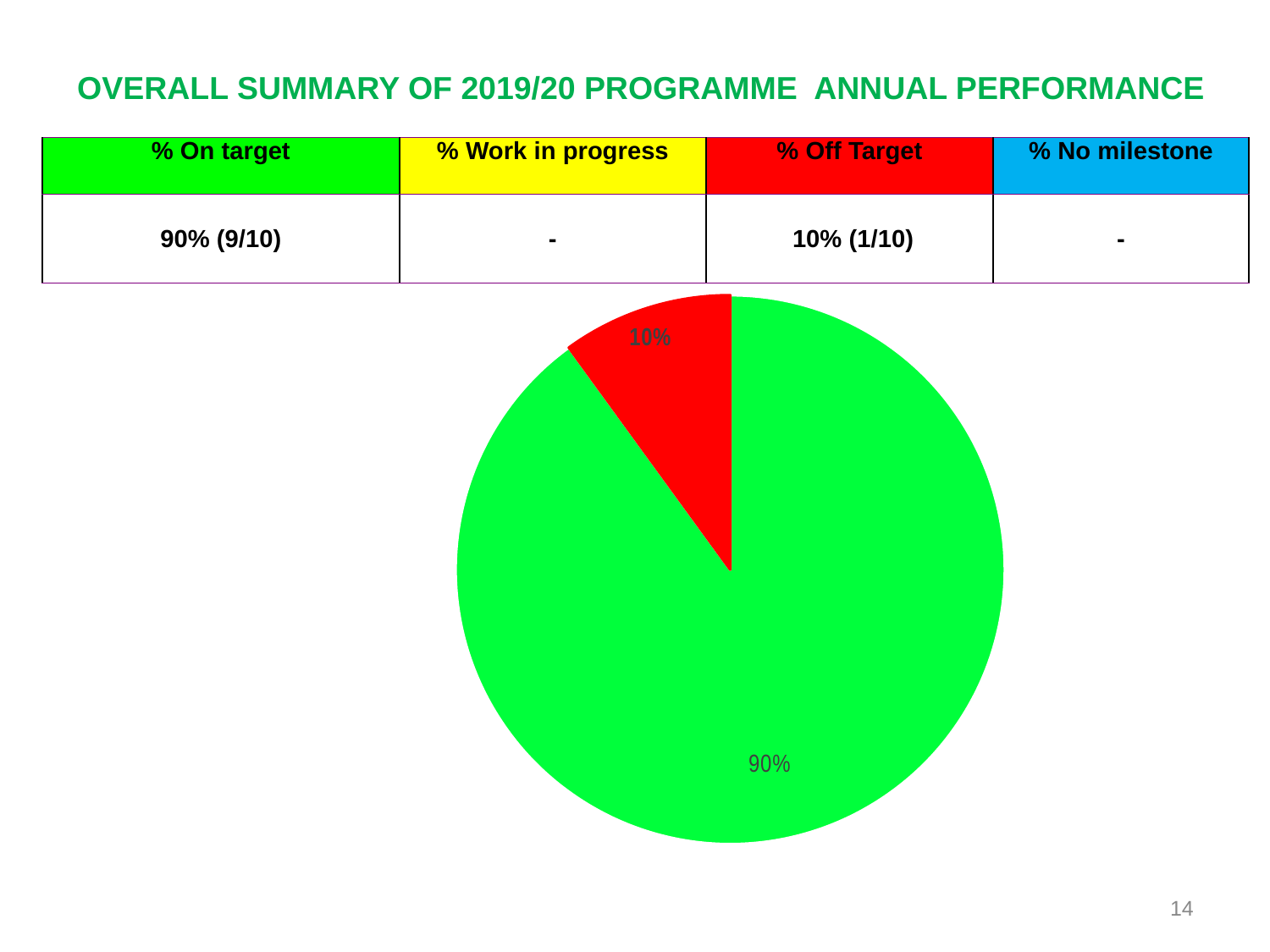
How many slices does the pie chart have? 2 What kind of chart is shown on the slide? pie chart What colour is the slice labelled 10%? red Is the share of the red slice greater or less than 25%? less Which slice of the pie chart is the largest? the green slice (90%) What share of the pie does the green slice represent? 90% Is the share of the green slice greater or less than 50%? greater What share of the pie does the red slice represent? 10% What colour is the slice labelled 90%? green What is the difference in percentage points between the green slice and the red slice? 80 Which slice of the pie chart is the smallest? the red slice (10%) Which is larger, the green slice or the red slice? the green slice